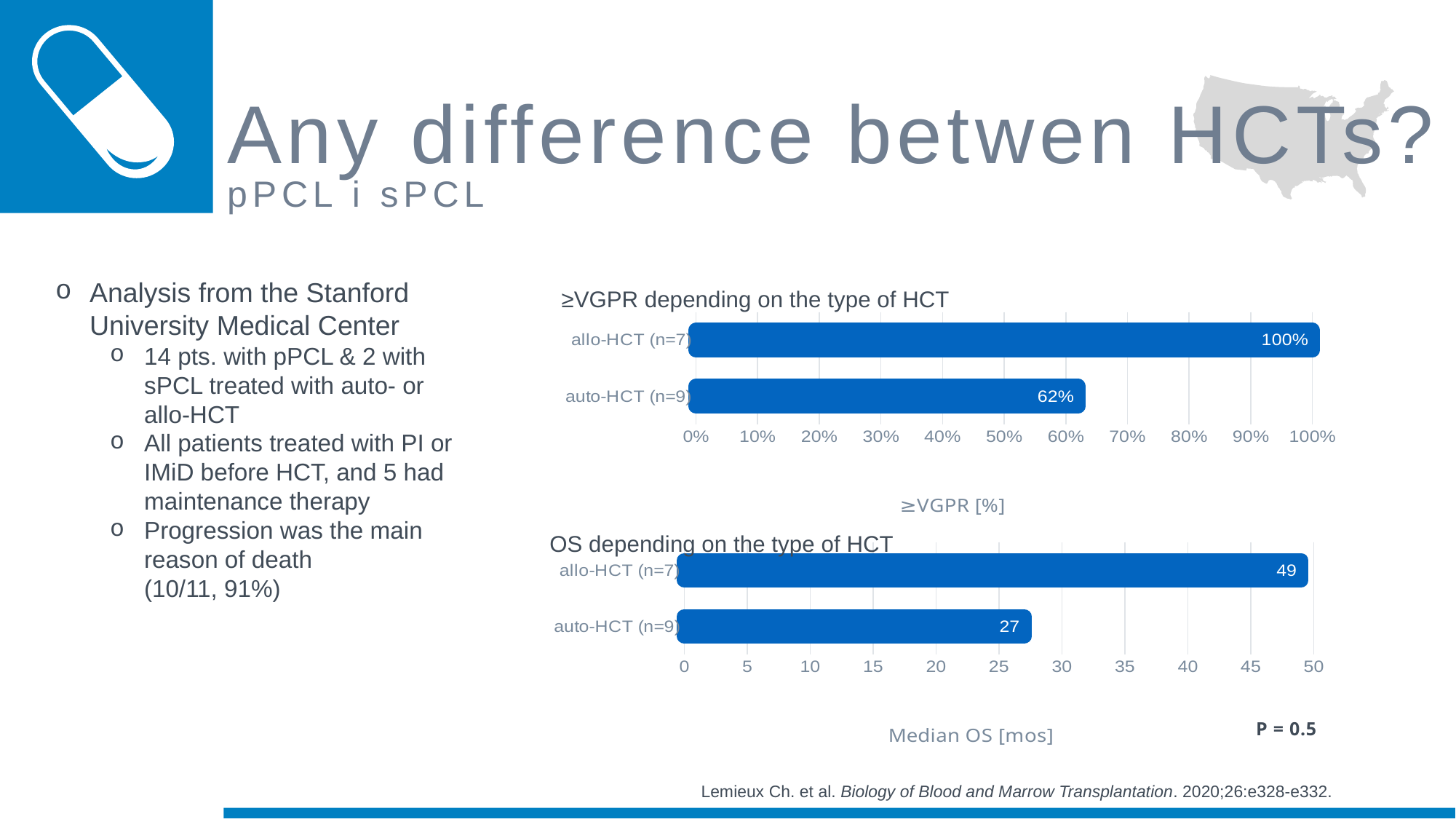
In the '≥VGPR depending on the type of HCT' chart, which category has the highest value? allo-HCT (n=7) How many categories are shown in the '≥VGPR depending on the type of HCT' chart? 2 In the 'OS depending on the type of HCT' chart, what is the median OS for allo-HCT (n=7)? 49 In the '≥VGPR depending on the type of HCT' chart, what is the value for auto-HCT (n=9)? 62% In the 'OS depending on the type of HCT' chart, what is the median OS for auto-HCT (n=9)? 27 In the 'OS depending on the type of HCT' chart, which is larger: the value for allo-HCT (n=7) or auto-HCT (n=9)? allo-HCT (n=7) In the '≥VGPR depending on the type of HCT' chart, what is the value for allo-HCT (n=7)? 100% In the '≥VGPR depending on the type of HCT' chart, what is the difference between the allo-HCT and auto-HCT values? 38% What kind of chart is the 'OS depending on the type of HCT' chart? bar chart What is the x-axis label of the 'OS depending on the type of HCT' chart? Median OS [mos] In the 'OS depending on the type of HCT' chart, which category has the lowest value? auto-HCT (n=9) In the 'OS depending on the type of HCT' chart, what is the difference in median OS between allo-HCT and auto-HCT? 22